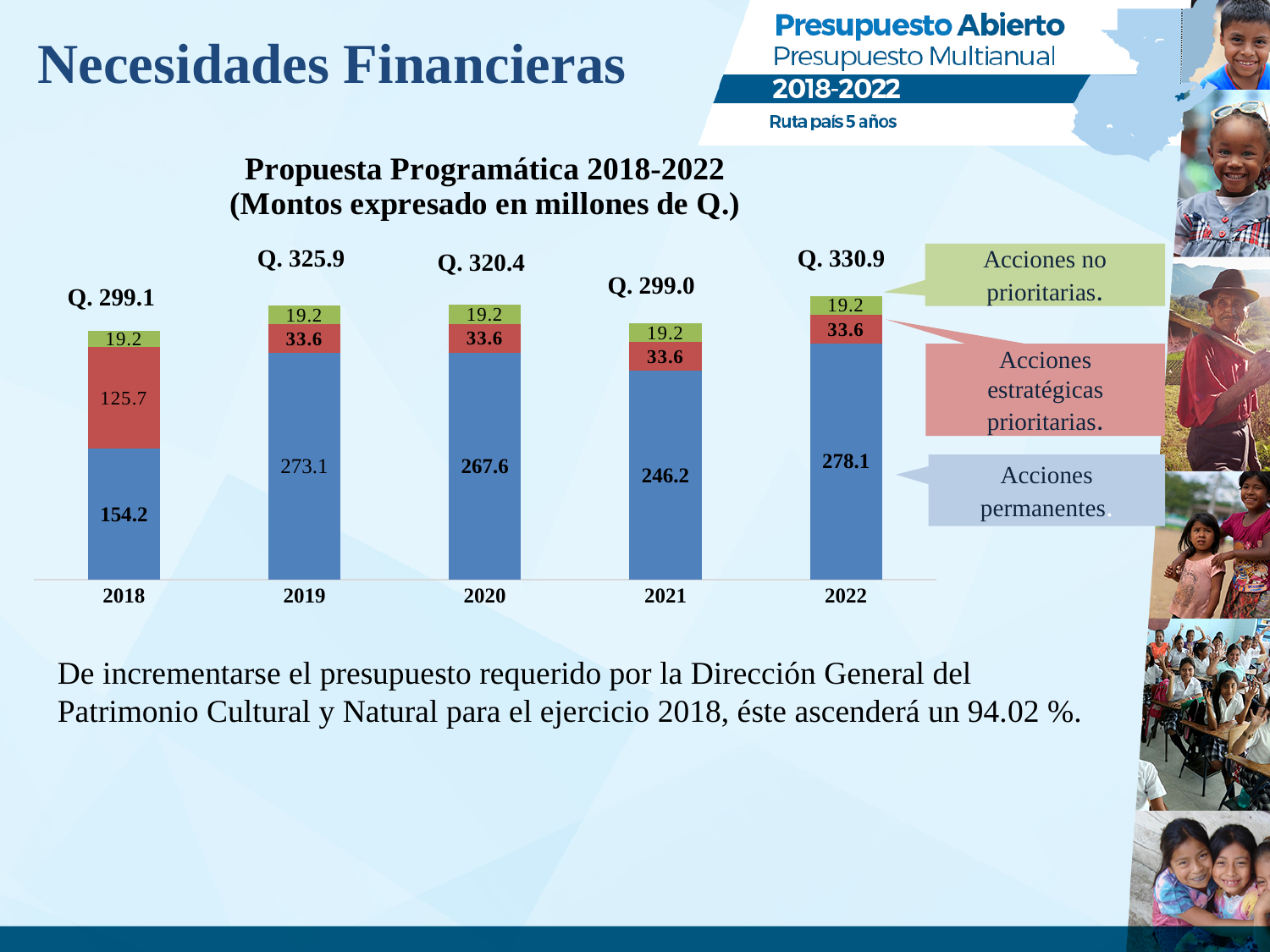
What kind of chart is shown on the slide? Stacked bar chart Which is larger, the Acciones permanentes value for 2019 or for 2020? 2019 Which year has the highest total? 2022 What is the total shown above the 2019 bar? Q. 325.9 What is the value for Acciones estratégicas prioritarias in 2018? 125.7 What is the total shown above the 2021 bar? Q. 299.0 How many years are shown on the x axis? 5 How many series are stacked in each bar? 3 What is the difference between the Acciones permanentes values for 2022 and 2021? 31.9 What is the value for Acciones permanentes in 2018? 154.2 Which year has the lowest value for Acciones permanentes? 2018 What is the value for Acciones permanentes in 2022? 278.1